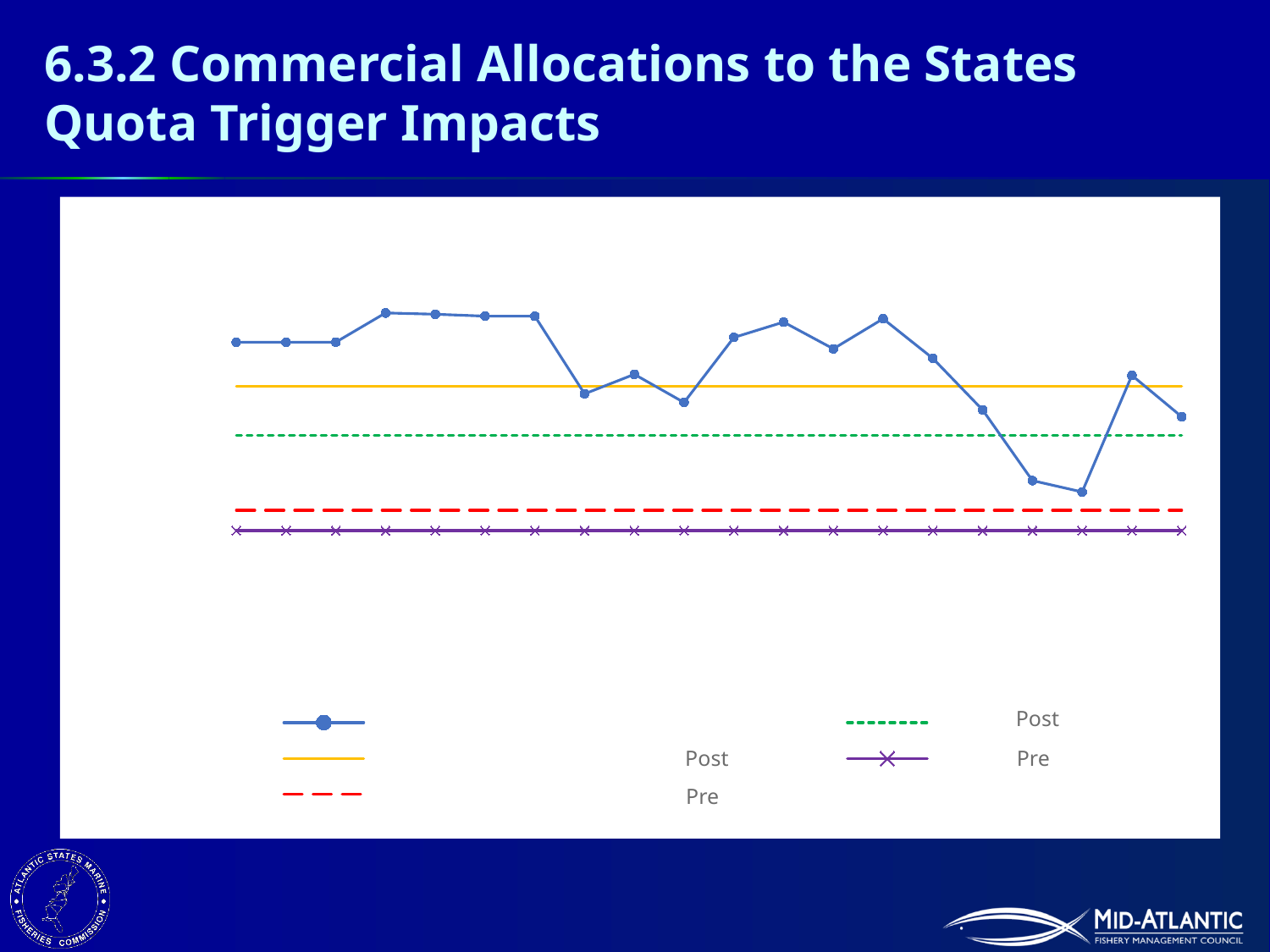
Is the orange solid line above or below the green dotted line? above Is the red dashed line above or below the purple line with x markers? above Does the blue line with circle markers end higher or lower than it starts? lower Which of the flat horizontal lines is the lowest on the chart? the purple line with x markers (Pre) What kind of chart is shown on the slide? line chart How many data points are plotted on the blue line with circle markers? 20 Is the lowest point of the blue line above or below the green dotted line? below How many series does the legend list? 5 What colour is the line with circle markers? blue Which of the flat horizontal lines is the highest on the chart? the orange solid line What marker shape is used on the purple line? x